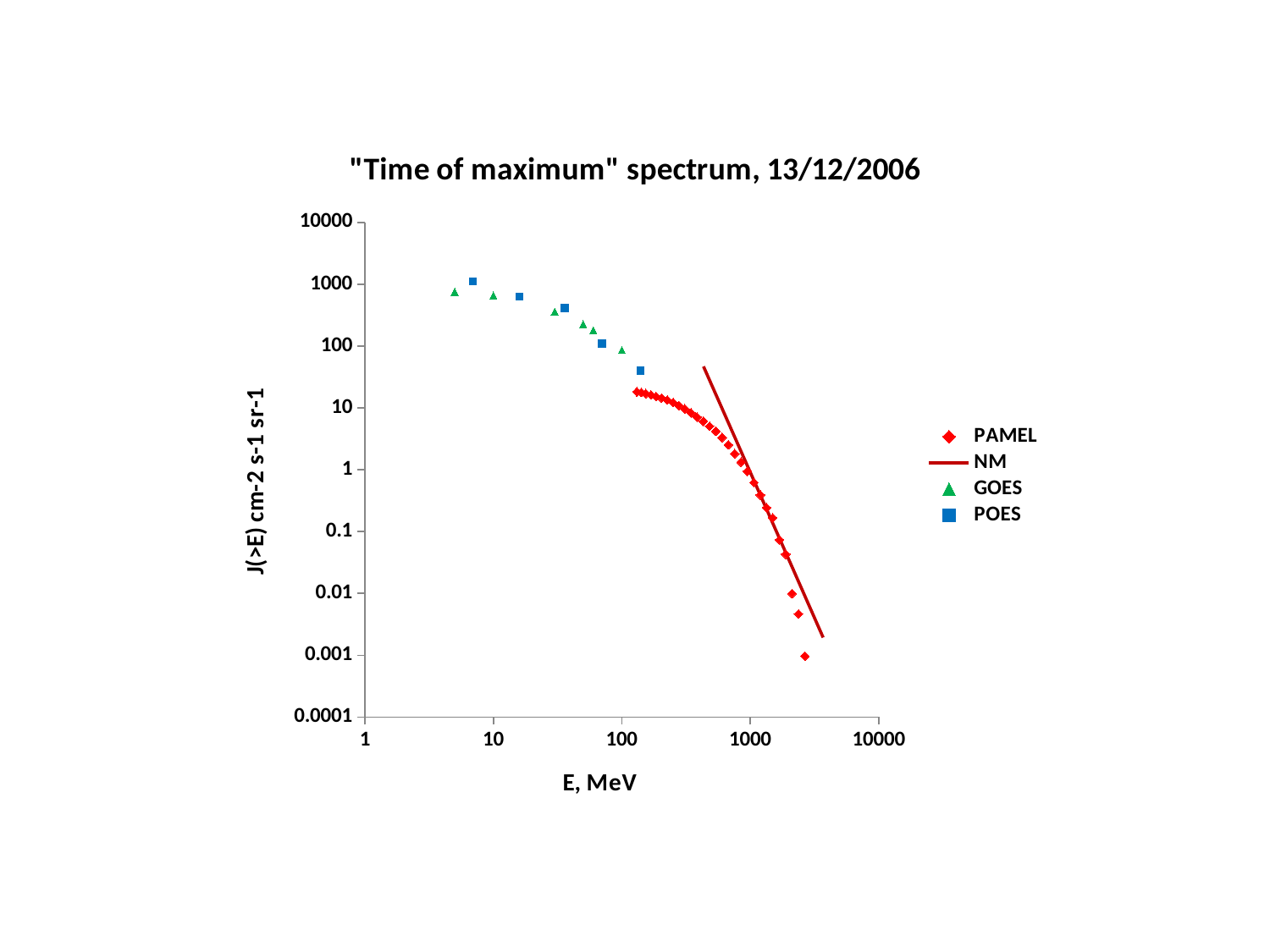
Which series extends to the highest energies on the x axis? NM What is the label of the x axis? E, MeV Is the value of the GOES point at E = 5 MeV greater or less than 1000? less Which series reaches the lowest values of J(>E) on the chart? PAMEL How many series does the legend list? 4 Which is larger: the GOES value at E = 5 MeV or the PAMEL value at E = 130 MeV? GOES value at E = 5 MeV How many POES points are plotted on the chart? 5 Is the value of the POES point near E = 140 MeV greater or less than 100? less What kind of chart is shown on the slide? scatter chart What is the title of the chart? "Time of maximum" spectrum, 13/12/2006 Do the plotted values rise or fall as E increases along the x axis? fall Is the value of the first PAMEL point near E = 130 MeV greater or less than 10? greater